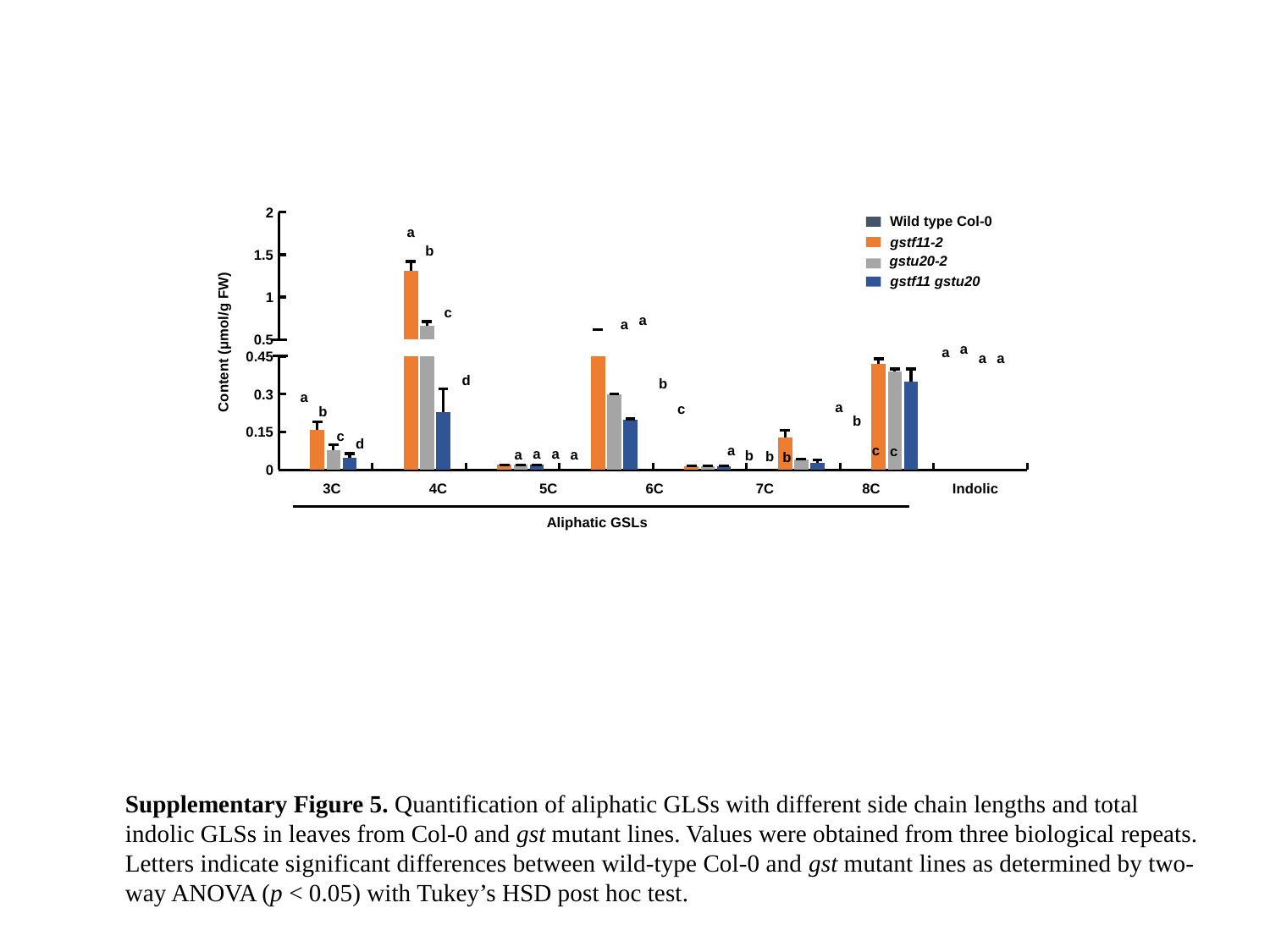
Is the value for gstf11-2 at 4C greater or less than 1? greater How many categories are shown along the x axis? 7 What kind of chart is shown on the slide? bar chart At 6C, which is larger: the gstf11-2 bar or the gstf11 gstu20 bar? gstf11-2 Which category has the highest bar for gstf11-2? 4C At 4C, which is larger: the gstf11-2 bar or the gstu20-2 bar? gstf11-2 Is the value for gstf11 gstu20 at 8C greater or less than 0.3? greater What is the label of the y axis? Content (µmol/g FW) Is the value for gstf11-2 at 8C greater or less than 0.3? greater How many series does the legend list? 4